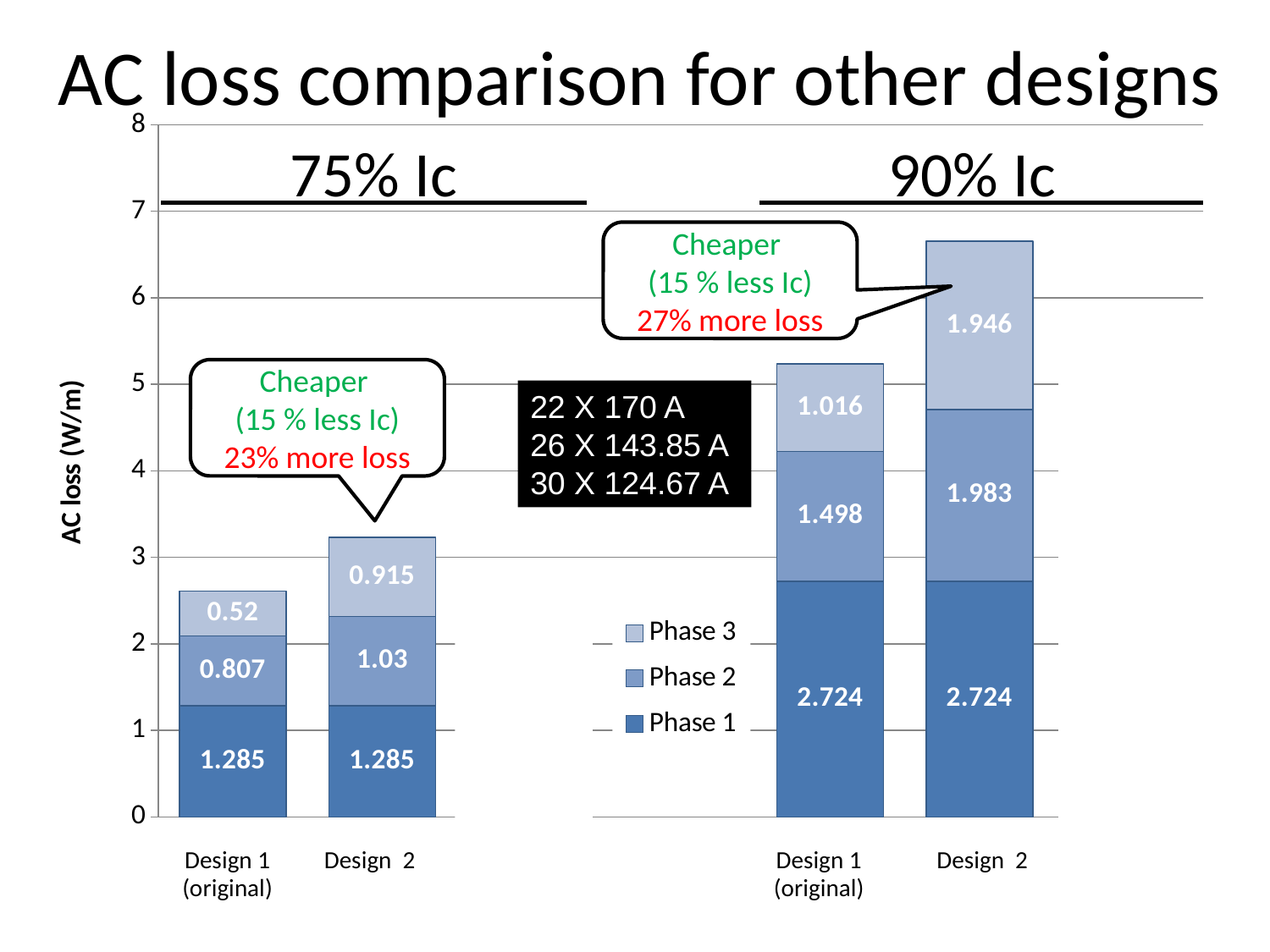
What is the Phase 2 AC loss for Design 1 (original) at 90% Ic? 1.498 Is the Phase 3 value larger for Design 2 at 75% Ic or for Design 1 (original) at 75% Ic? Design 2 at 75% Ic What is the total AC loss of the stacked bar for Design 2 at 90% Ic? 6.653 Which bar has the highest total AC loss? Design 2 at 90% Ic What is the label of the vertical axis? AC loss (W/m) What is the Phase 1 AC loss for Design 1 (original) at 75% Ic? 1.285 What is the total AC loss of the stacked bar for Design 1 (original) at 75% Ic? 2.612 What is the Phase 3 AC loss for Design 2 at 75% Ic? 0.915 How many series does the legend list? 3 What kind of chart is shown on the slide? Stacked bar chart What is the Phase 3 AC loss for Design 2 at 90% Ic? 1.946 What is the difference between the Phase 2 values of Design 2 and Design 1 (original) at 90% Ic? 0.485